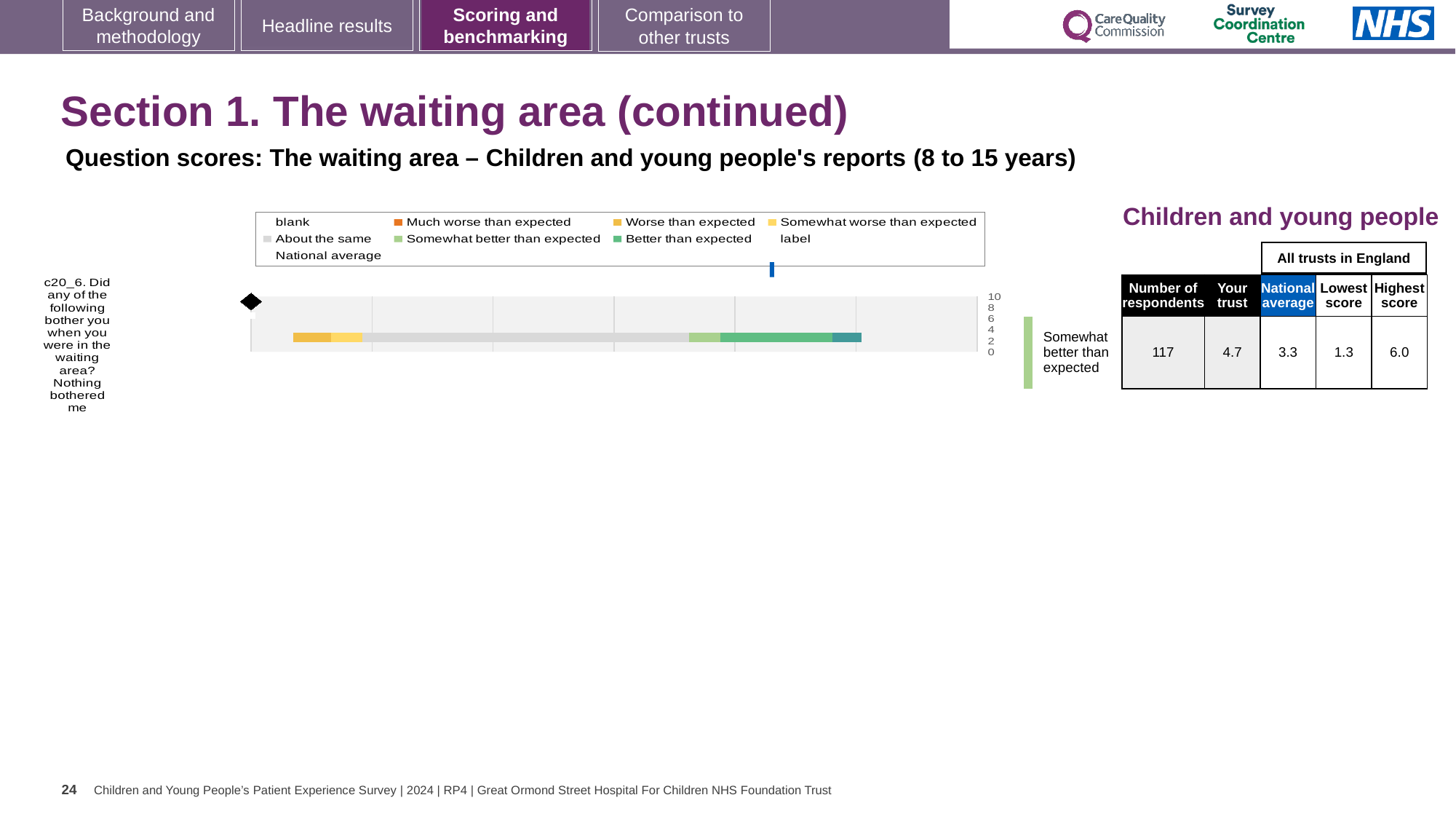
What benchmark category is given for question c20_6 next to the chart? Somewhat better than expected In the table, what is the number of respondents for question c20_6? 117 In the table, what is the national average score for question c20_6? 3.3 What kind of chart is shown on the slide? bar chart In the table, what is the highest score among all trusts in England? 6.0 In the table, what is the lowest score among all trusts in England? 1.3 In the table, what is the 'Your trust' score for question c20_6? 4.7 What is the difference between the 'Your trust' score and the national average for question c20_6? 1.4 How many survey questions are plotted in the chart? 1 What is the highest value shown on the chart's numeric axis? 10 Which is larger for question c20_6: the 'Your trust' score or the national average? Your trust Which legend entry is shown in dark orange? Much worse than expected